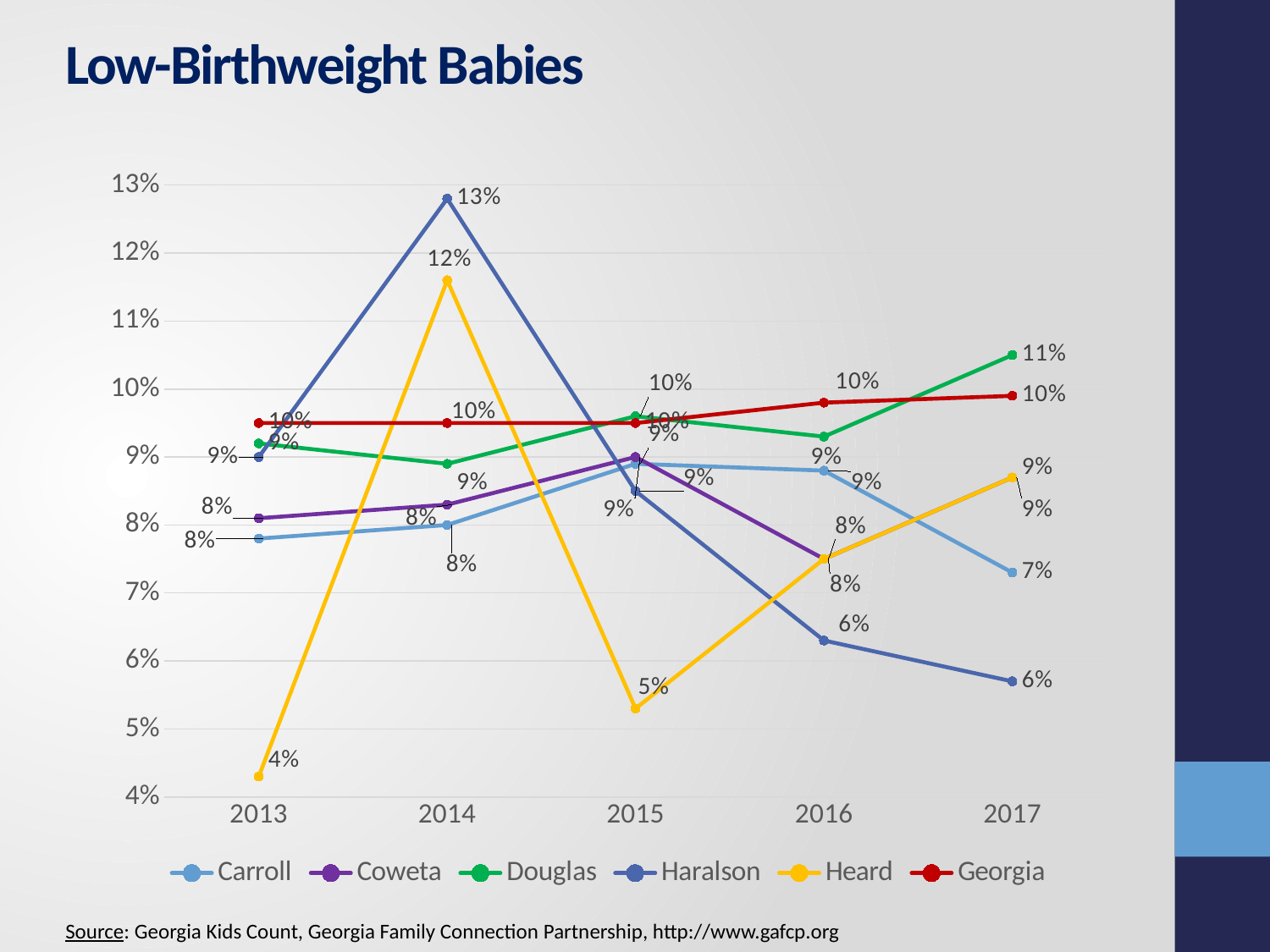
How many series does the legend list? 6 How many years are shown on the x axis? 5 What is the value for Douglas in 2017? 11% By how many percentage points did Heard's value rise from 2013 to 2014? 8 percentage points What is the value for Carroll in 2017? 7% Does the Haralson line rise or fall from 2014 to 2017? fall What kind of chart is shown on the slide? line chart What is the value for Haralson in 2014? 13% Which series has the highest value in 2014? Haralson In 2017, which is larger, the value for Douglas or the value for Carroll? Douglas What is the value for Heard in 2013? 4% Which series has the lowest value in 2013? Heard